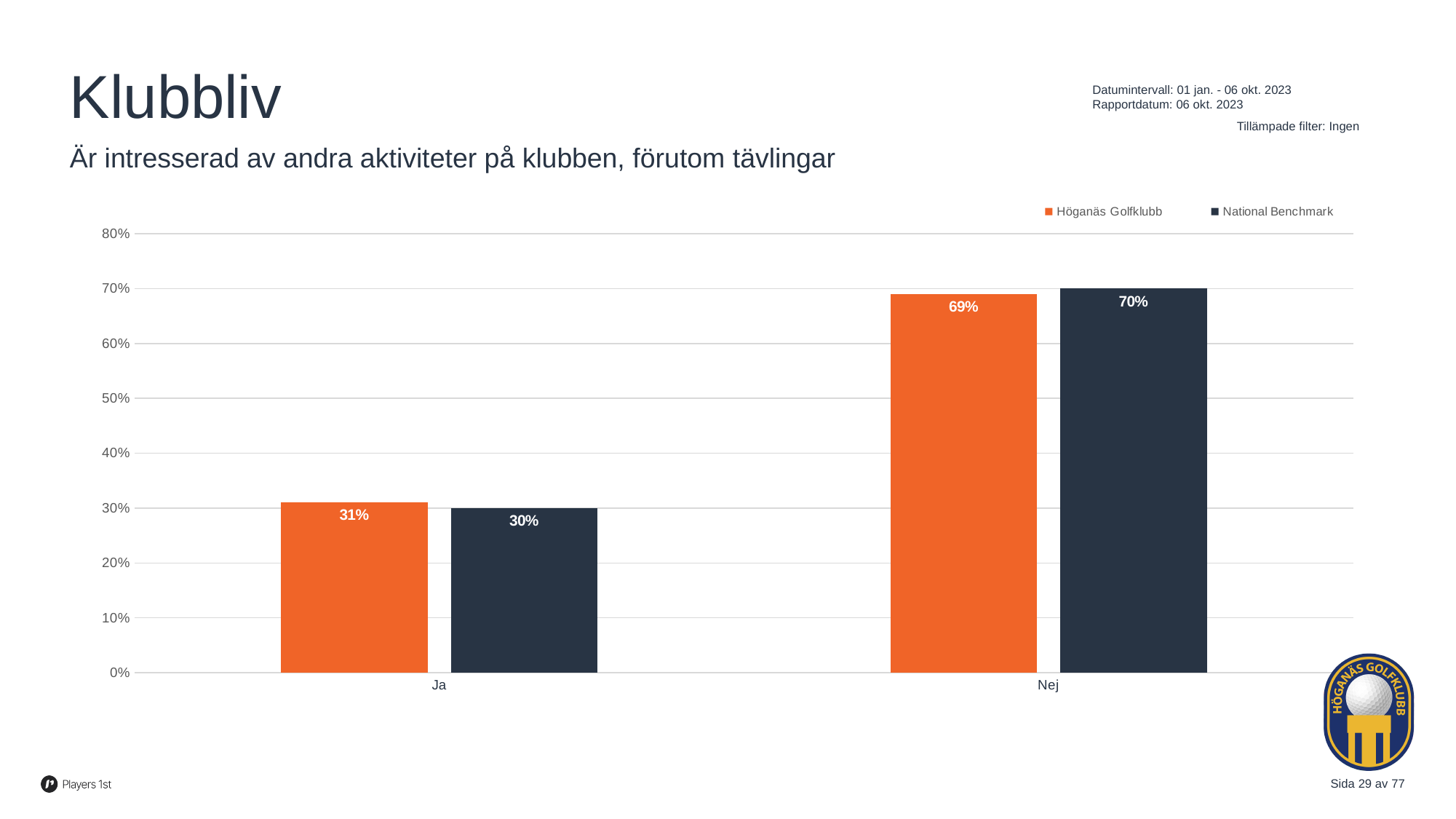
What is the difference between the Höganäs Golfklubb values for Nej and Ja? 38% What is the value for National Benchmark for the category Ja? 30% What is the value for Höganäs Golfklubb for the category Nej? 69% How many series does the legend list? 2 What is the value for National Benchmark for the category Nej? 70% How many categories are shown on the x axis? 2 What is the difference between the National Benchmark and Höganäs Golfklubb values for Nej? 1% Is the Höganäs Golfklubb value for Nej greater or less than 60%? greater Which category has the lowest value for National Benchmark? Ja What kind of chart is shown on the slide? Bar chart What is the value for Höganäs Golfklubb for the category Ja? 31% Which category has the highest value for Höganäs Golfklubb? Nej